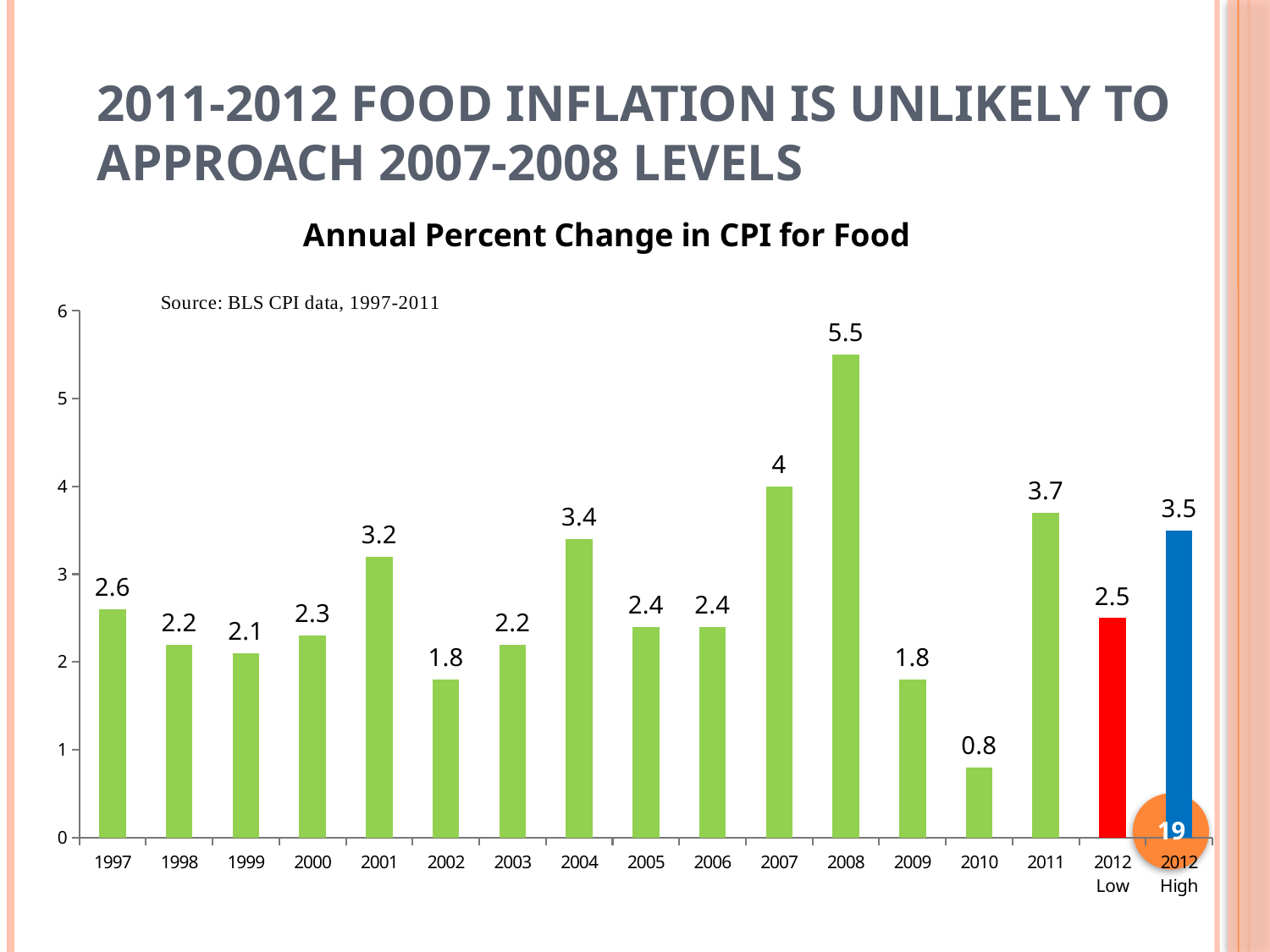
What is the title of the chart? Annual Percent Change in CPI for Food What kind of chart is shown on the slide? Bar chart What value is shown for the 2012 High bar? 3.5 What is the difference between the values for 2008 and 2007? 1.5 Which year has the highest annual percent change in CPI for food? 2008 What is the difference between the 2012 High and 2012 Low values? 1 Which is larger, the value for 2004 or the value for 2001? 2004 How many bars are plotted on the chart? 17 What value is shown for the 2012 Low bar? 2.5 What is the annual percent change in CPI for food shown for 2008? 5.5 What value is shown for 2011? 3.7 Which year has the lowest annual percent change in CPI for food? 2010